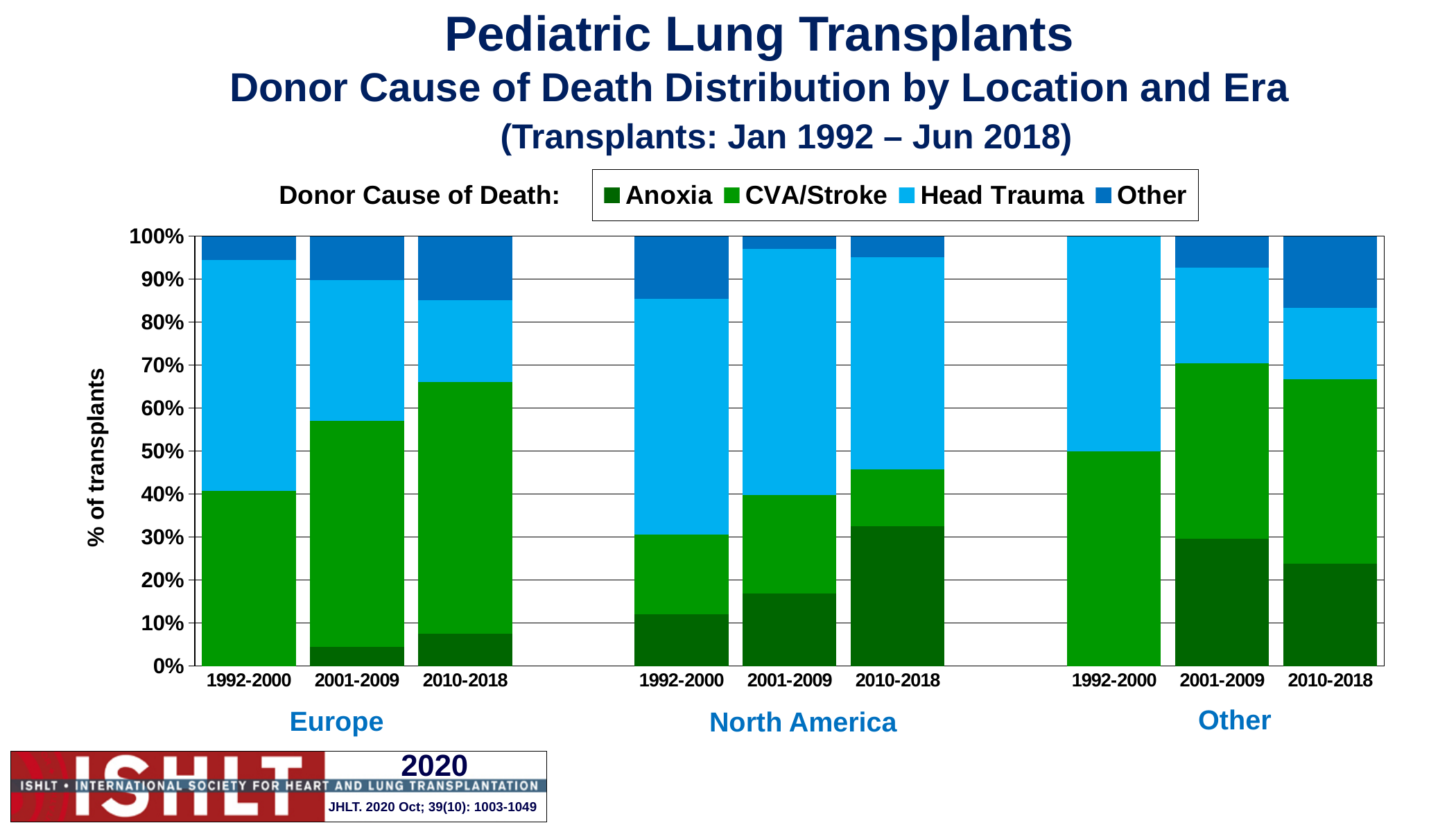
Is the Anoxia share for Other 2001-2009 greater or less than 20%? greater What is the label on the y axis? % of transplants Which three locations are shown along the x axis? Europe, North America, Other Does the Anoxia share in North America rise or fall from 1992-2000 to 2010-2018? rise Which has the larger Anoxia share: North America 2010-2018 or Europe 2010-2018? North America 2010-2018 How many bars are plotted in the chart? 9 Within North America, which era has the smallest Anoxia share? 1992-2000 Is the Anoxia share for North America 2010-2018 greater or less than 20%? greater Is the Anoxia share for Europe 2001-2009 greater or less than 10%? less Within Europe, which era has the largest Anoxia share? 2010-2018 What kind of chart is shown on the slide? Stacked bar chart How many donor causes of death does the legend list? 4